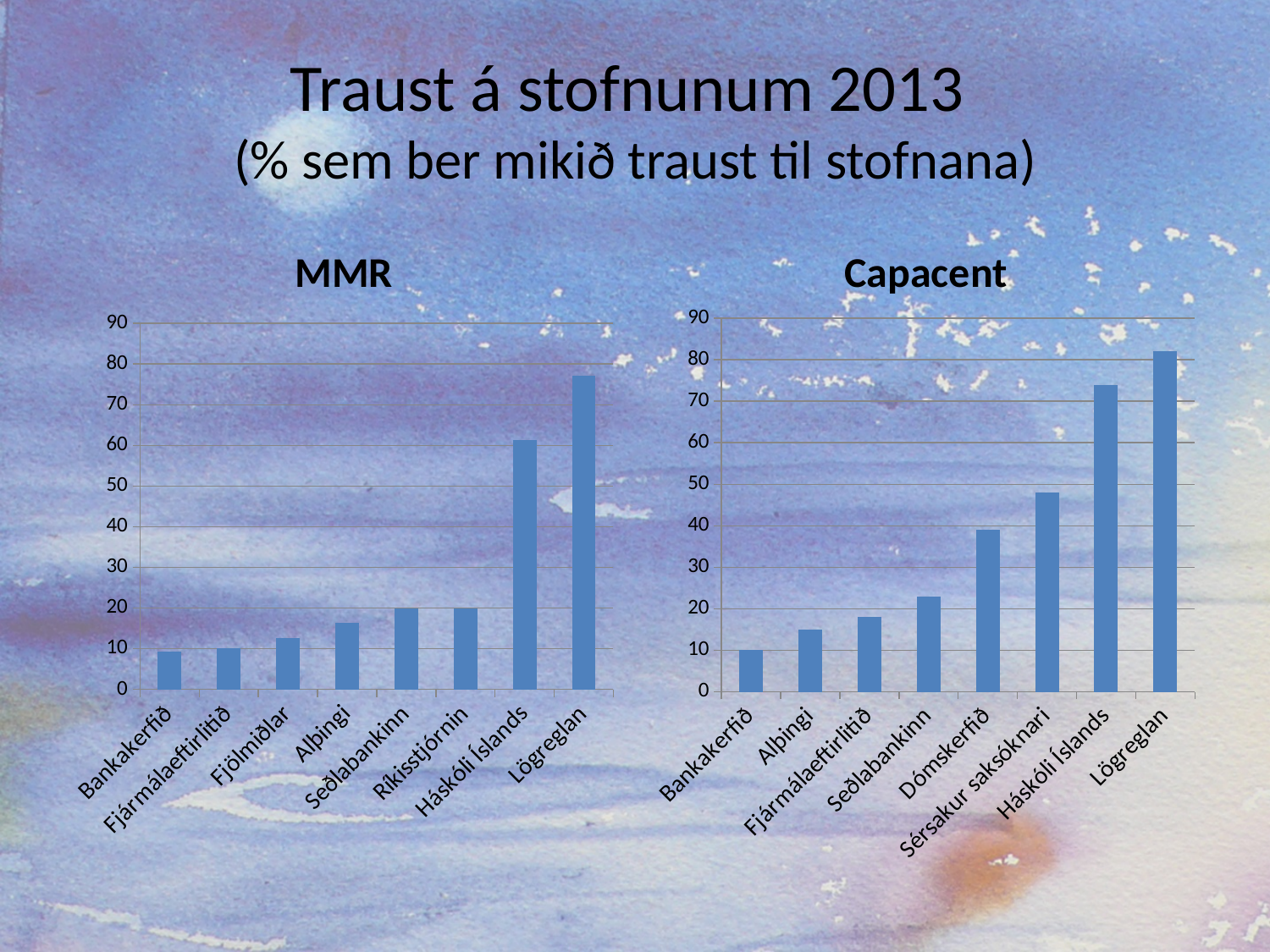
In the Capacent chart, which category has the highest value? Lögreglan In the Capacent chart, do the values rise or fall from left to right along the x axis? rise In the Capacent chart, is the value for Dómskerfið greater or less than 30? greater In the Capacent chart, which category has the lowest value? Bankakerfið In the MMR chart, which is larger, the value for Háskóli Íslands or the value for Seðlabankinn? Háskóli Íslands In the MMR chart, which category has the highest value? Lögreglan In the MMR chart, is the value for Alþingi greater or less than 20? less In the Capacent chart, which is larger, the value for Alþingi or the value for Seðlabankinn? Seðlabankinn What kind of chart is the Capacent chart? bar chart How many categories are shown in the MMR chart? 8 In the Capacent chart, is the value for Sérsakur saksóknari greater or less than 50? less